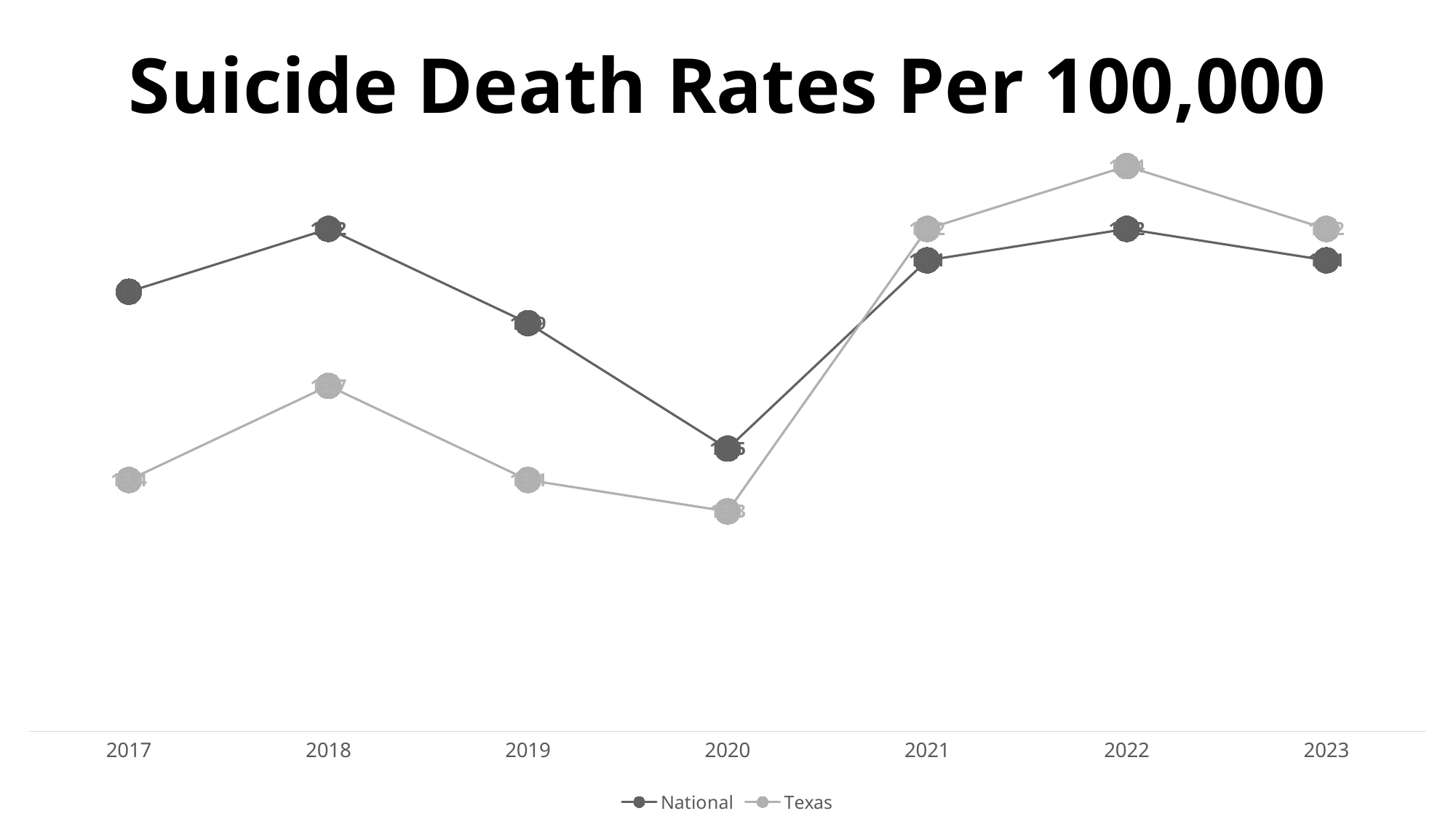
In which year is the National series at its lowest point? 2020 What is the title of the chart? Suicide Death Rates Per 100,000 In 2017, which series has the higher value, National or Texas? National How many series does the legend list? 2 Does the Texas series rise or fall from 2020 to 2022? rise In which year is the Texas series at its highest point? 2022 In which year is the Texas series at its lowest point? 2020 In 2022, which series has the higher value, National or Texas? Texas Does the National series rise or fall from 2018 to 2020? fall How many years are plotted along the x axis? 7 What kind of chart is shown on the slide? line chart In 2019, which series has the lower value, National or Texas? Texas